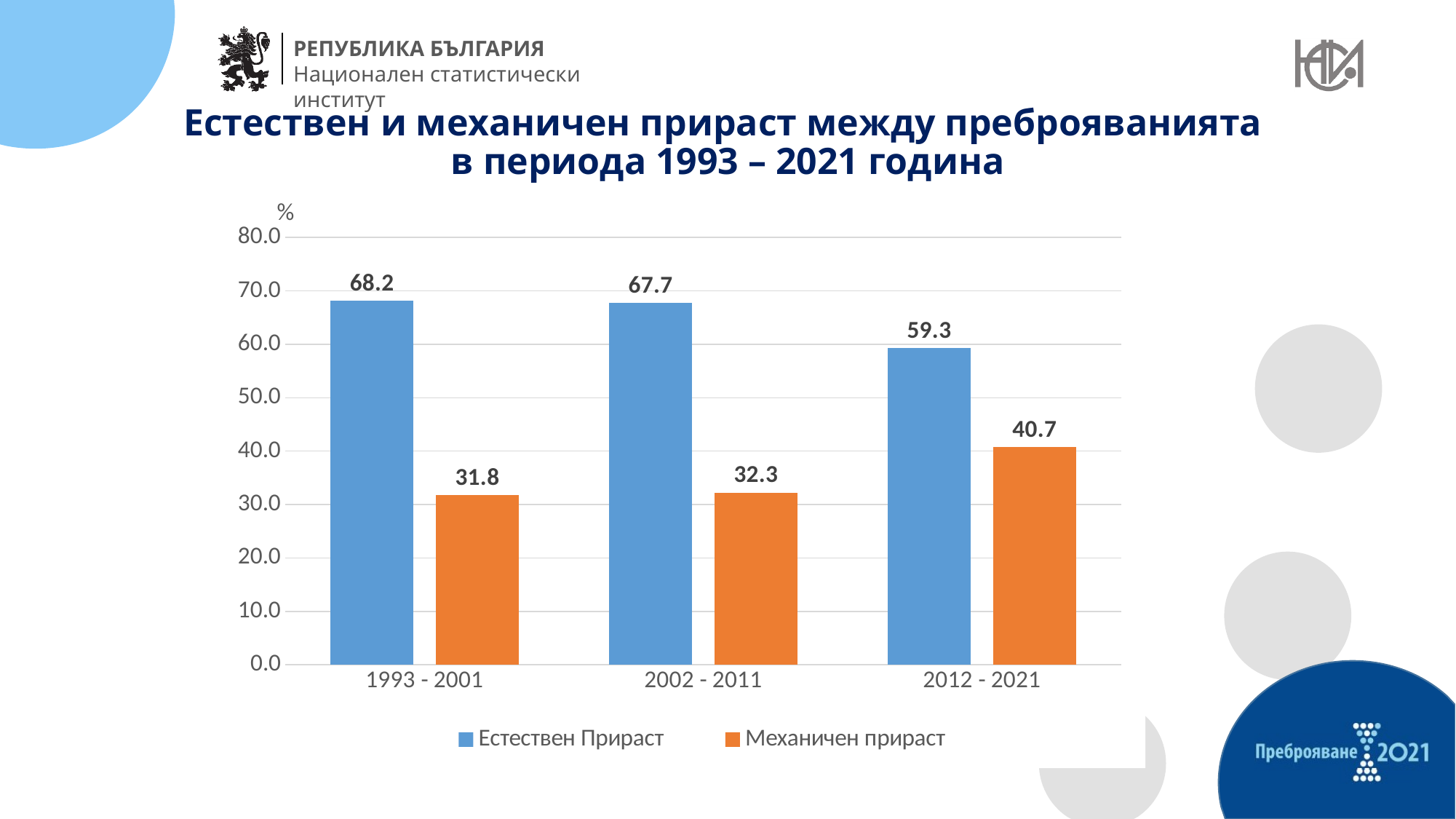
Which period has the highest value for Естествен Прираст? 1993 - 2001 Which period has the lowest value for Механичен прираст? 1993 - 2001 How many series does the legend list? 2 What kind of chart is shown on the slide? bar chart What is the difference between Естествен Прираст and Механичен прираст for 2012 - 2021? 18.6 Is the value of Механичен прираст for 2012 - 2021 greater or less than 40.0? greater What is the value of Естествен Прираст for 1993 - 2001? 68.2 Does the value of Естествен Прираст rise or fall across the periods from 1993 - 2001 to 2012 - 2021? fall Which is larger for 2002 - 2011: Естествен Прираст or Механичен прираст? Естествен Прираст How many periods are shown on the x axis? 3 What is the value of Механичен прираст for 2012 - 2021? 40.7 What is the value of Механичен прираст for 2002 - 2011? 32.3